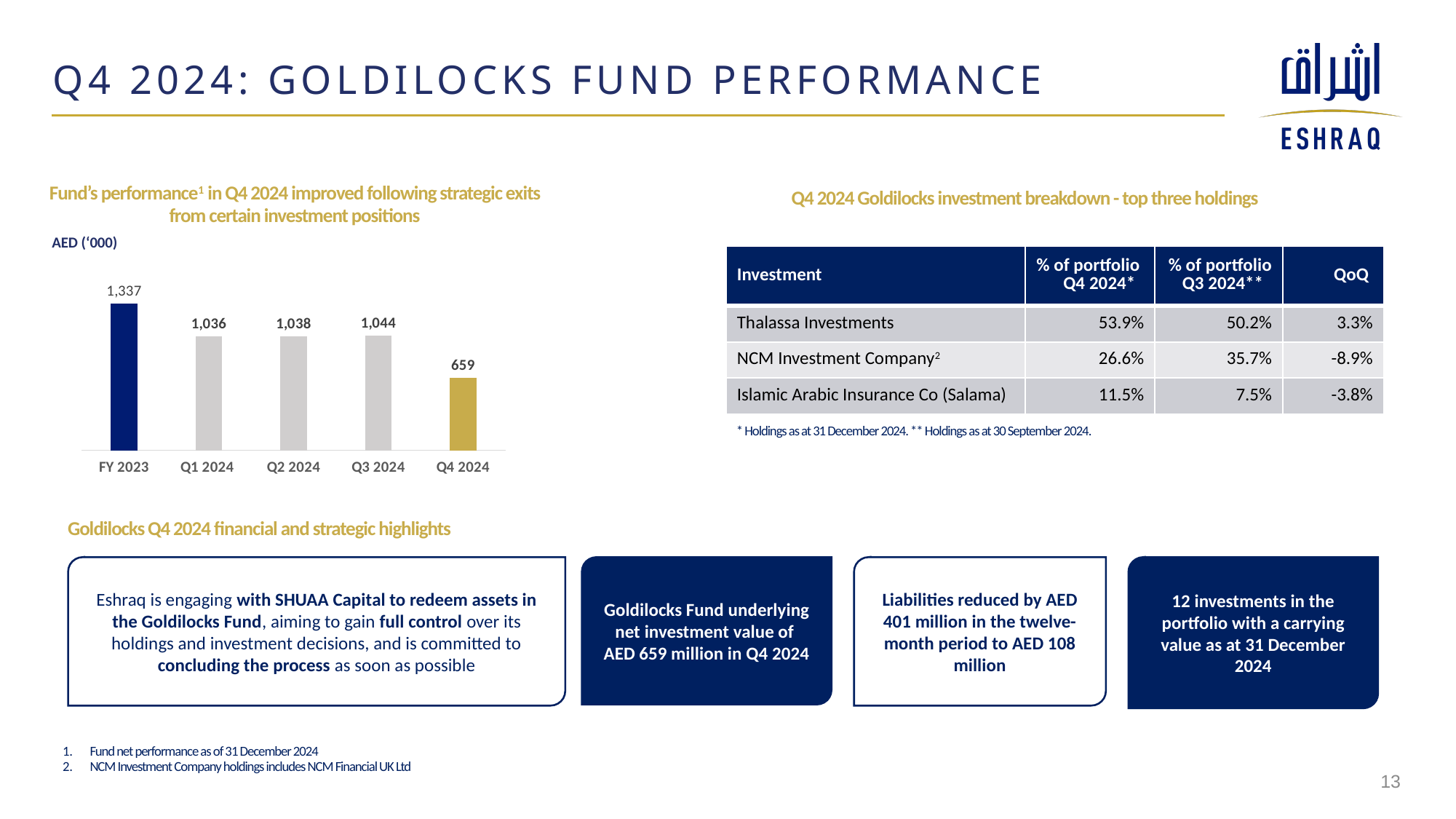
What is the value for Q4 2024 in the fund performance bar chart? 659 In the fund performance bar chart, which is larger: the value for Q1 2024 or Q4 2024? Q1 2024 What unit is shown above the fund performance bar chart? AED ('000) In the fund performance bar chart, does the value rise or fall from Q3 2024 to Q4 2024? Fall What is the difference between the FY 2023 and Q1 2024 values in the fund performance bar chart? 301 What type of chart is used to show the fund's performance? Bar chart What is the value for FY 2023 in the fund performance bar chart? 1,337 What is the difference between the Q3 2024 and Q4 2024 values in the fund performance bar chart? 385 How many bars are shown in the fund performance bar chart? 5 What is the value for Q2 2024 in the fund performance bar chart? 1,038 Which period has the highest value in the fund performance bar chart? FY 2023 Which period has the lowest value in the fund performance bar chart? Q4 2024